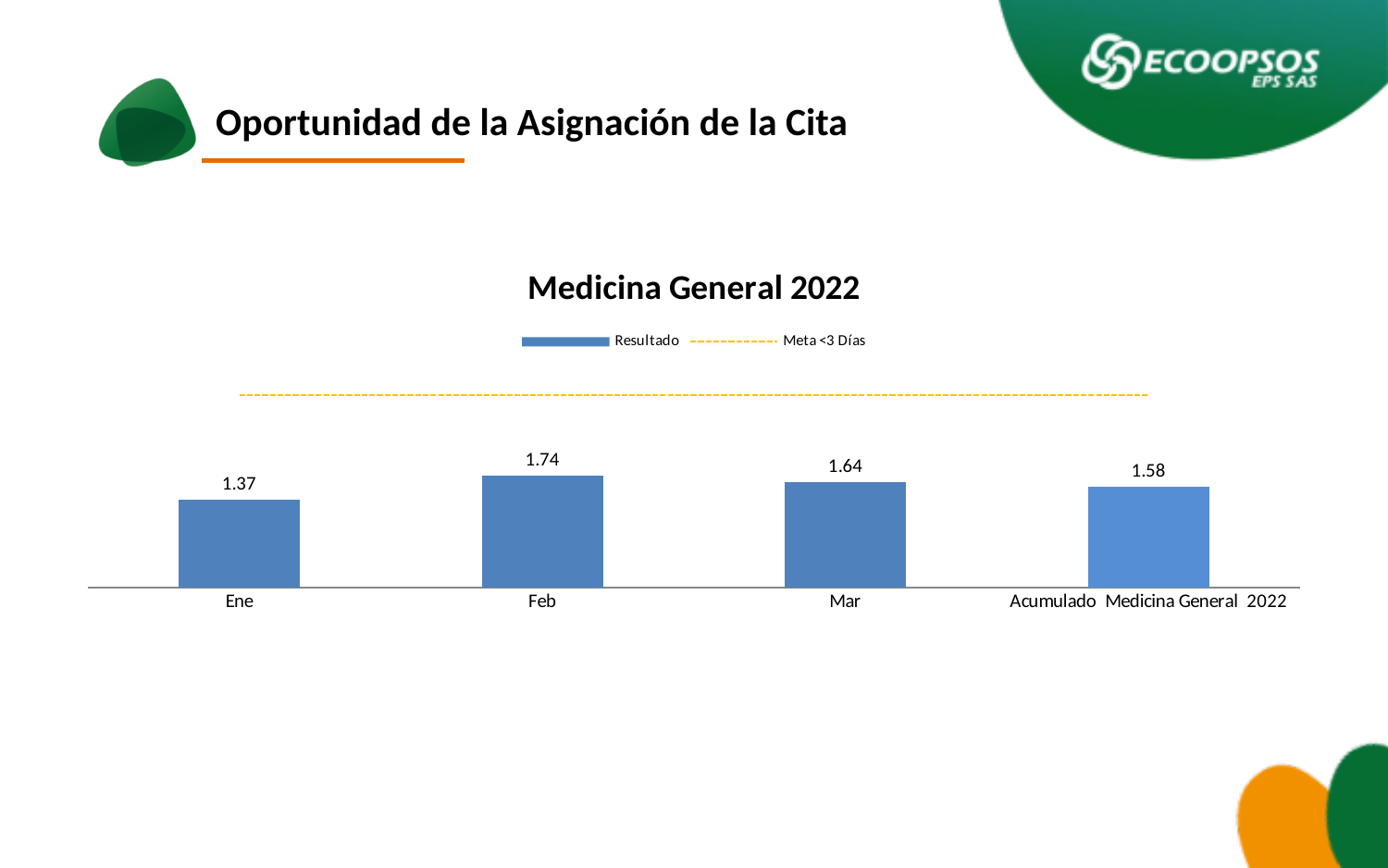
Which category has the highest value? Feb What is the difference between the values for Feb and Ene? 0.37 What is the value for Feb? 1.74 What is the value for Ene? 1.37 How many series does the legend list? 2 Which is larger, the value for Mar or the value for Ene? Mar Which category has the lowest value? Ene How many categories are shown on the x axis? 4 What is the value for Acumulado Medicina General 2022? 1.58 What is the title of the chart? Medicina General 2022 What kind of chart is this? combination bar and line chart What is the value for Mar? 1.64